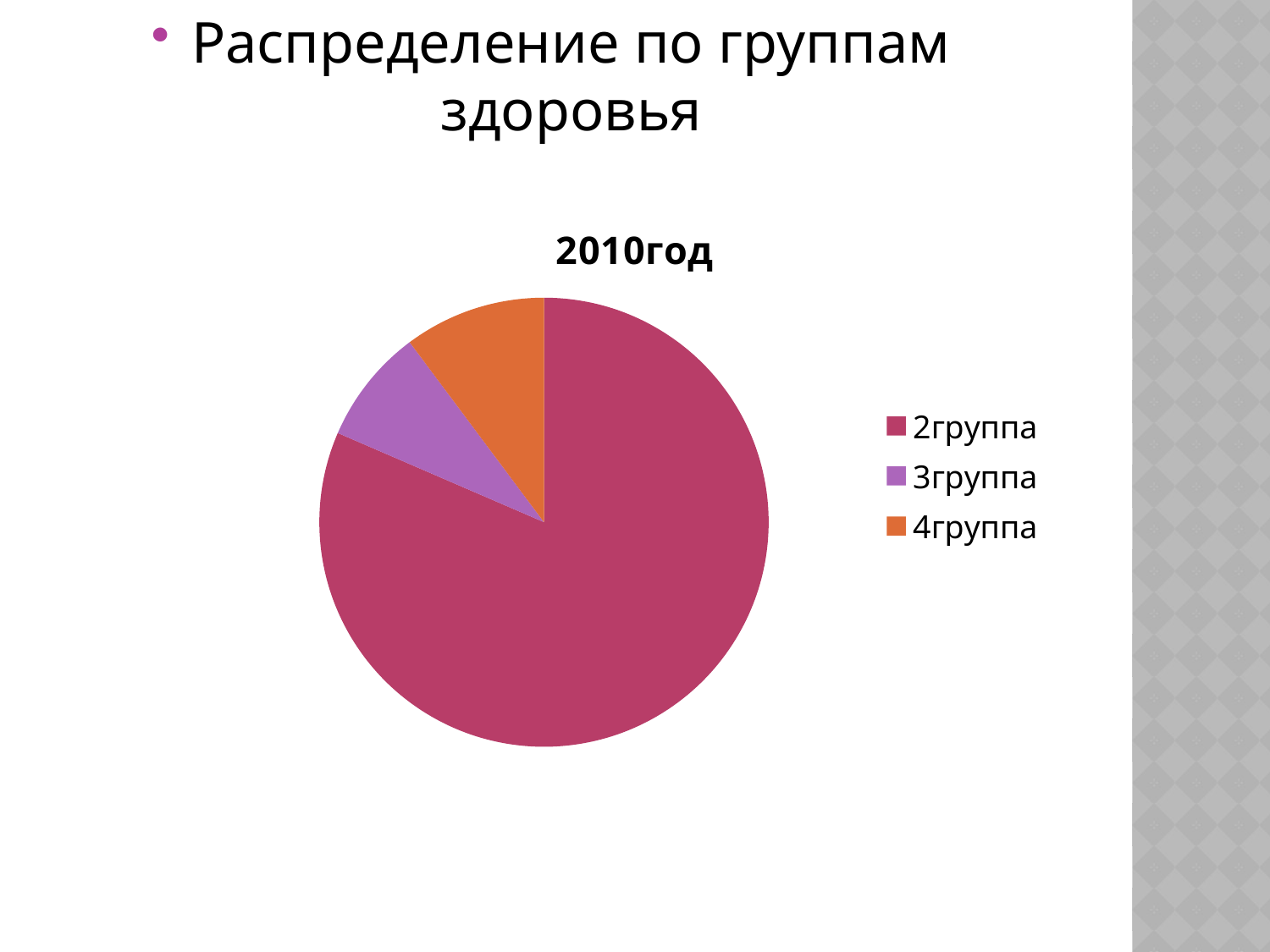
How many entries does the legend of the pie chart list? 3 What colour is the slice for 4группа in the pie chart? orange How many slices does the pie chart have? 3 Which group has the largest slice in the pie chart? 2группа What kind of chart is shown on the slide? pie chart What is the title of the pie chart? 2010год Which slice is larger, 2группа or 4группа? 2группа Which legend entry is listed first in the pie chart's legend? 2группа Which slice is larger, 2группа or 3группа? 2группа